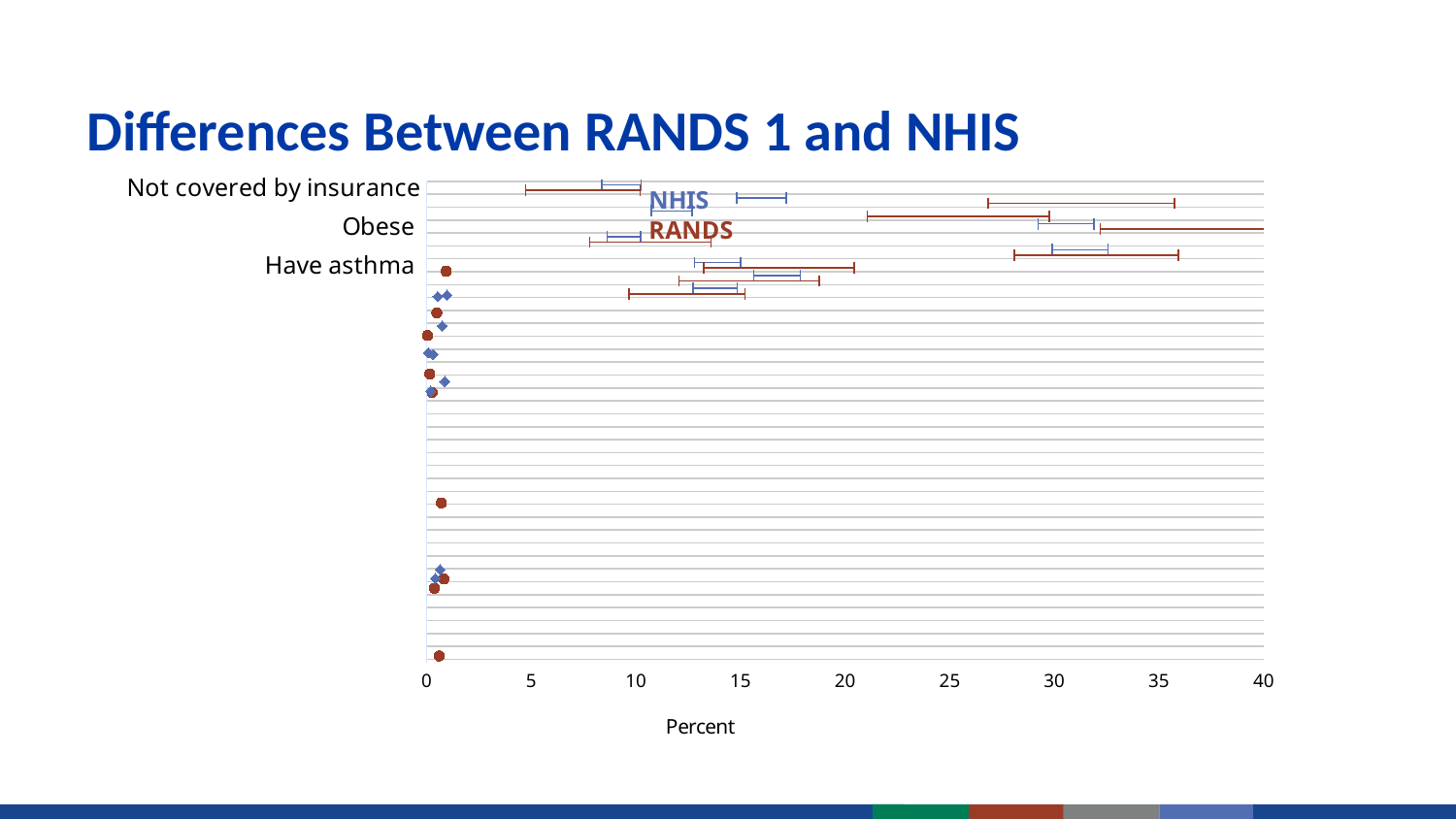
What is the maximum value shown on the x axis of the chart? 40 Is the value for Not covered by insurance greater or less than 20? less What label is shown on the x axis of the chart? Percent What are the names of the two series shown in the chart? NHIS and RANDS Which category has the higher values, Obese or Not covered by insurance? Obese Is the value for Obese greater or less than 20? greater